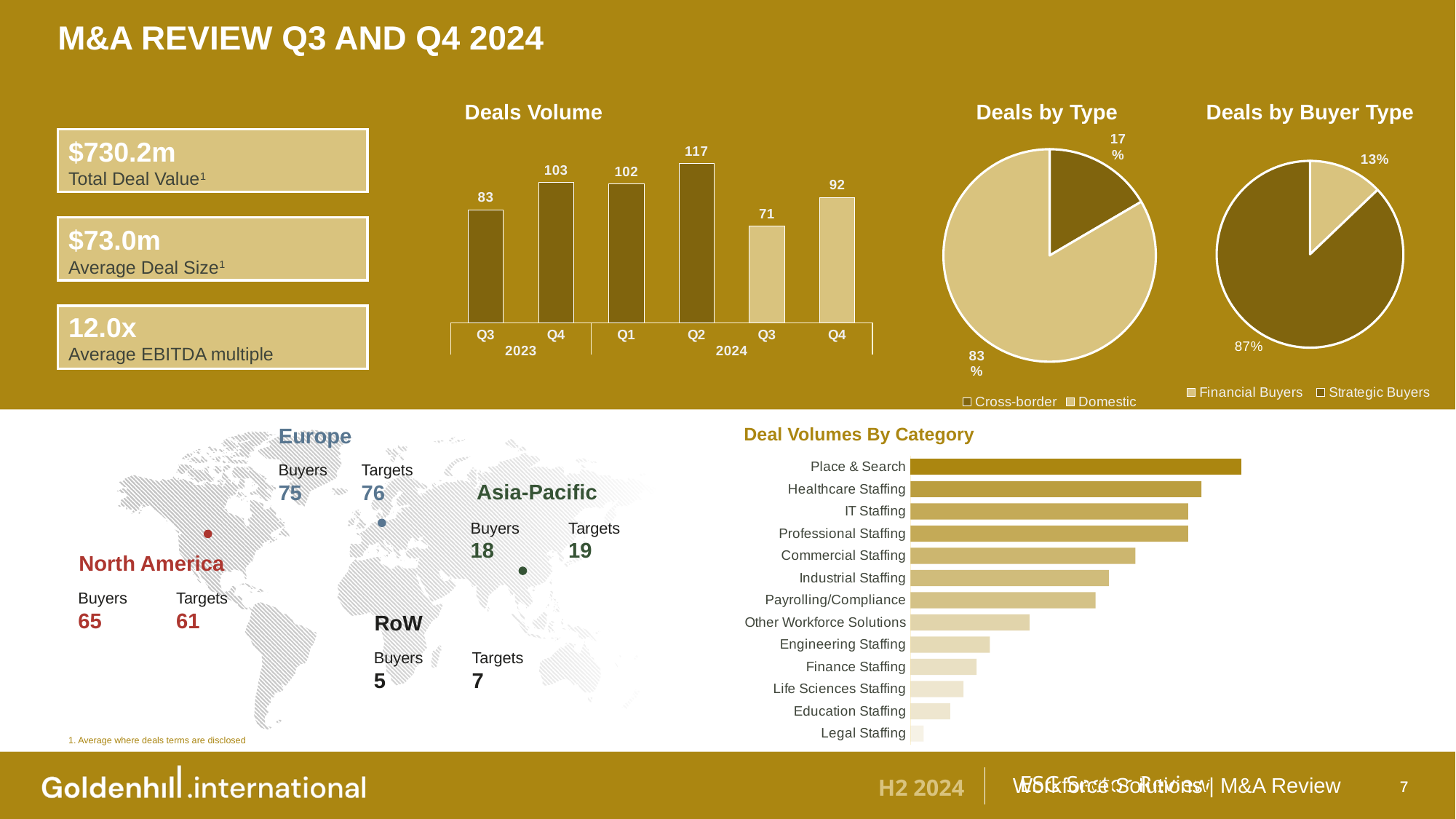
In the Deals Volume chart, which quarter has the lowest deal volume? Q3 2024 In the Deals Volume chart, what is the difference between Q2 2024 and Q3 2024? 46 How many categories are listed in the Deal Volumes By Category chart? 13 In the Deals Volume chart, what is the value for Q2 2024? 117 In the Deals Volume chart, which is larger, Q4 2023 or Q4 2024? Q4 2023 In the Deals Volume chart, which quarter has the highest deal volume? Q2 2024 In the Deals by Buyer Type pie chart, what share is Strategic Buyers? 87% In the Deal Volumes By Category chart, which category has the longest bar? Place & Search What kind of chart is the Deals Volume chart? Bar chart In the Deals Volume chart, what is the value for Q3 2023? 83 How many bars are shown in the Deals Volume chart? 6 In the Deals by Type pie chart, what share is Domestic? 83%